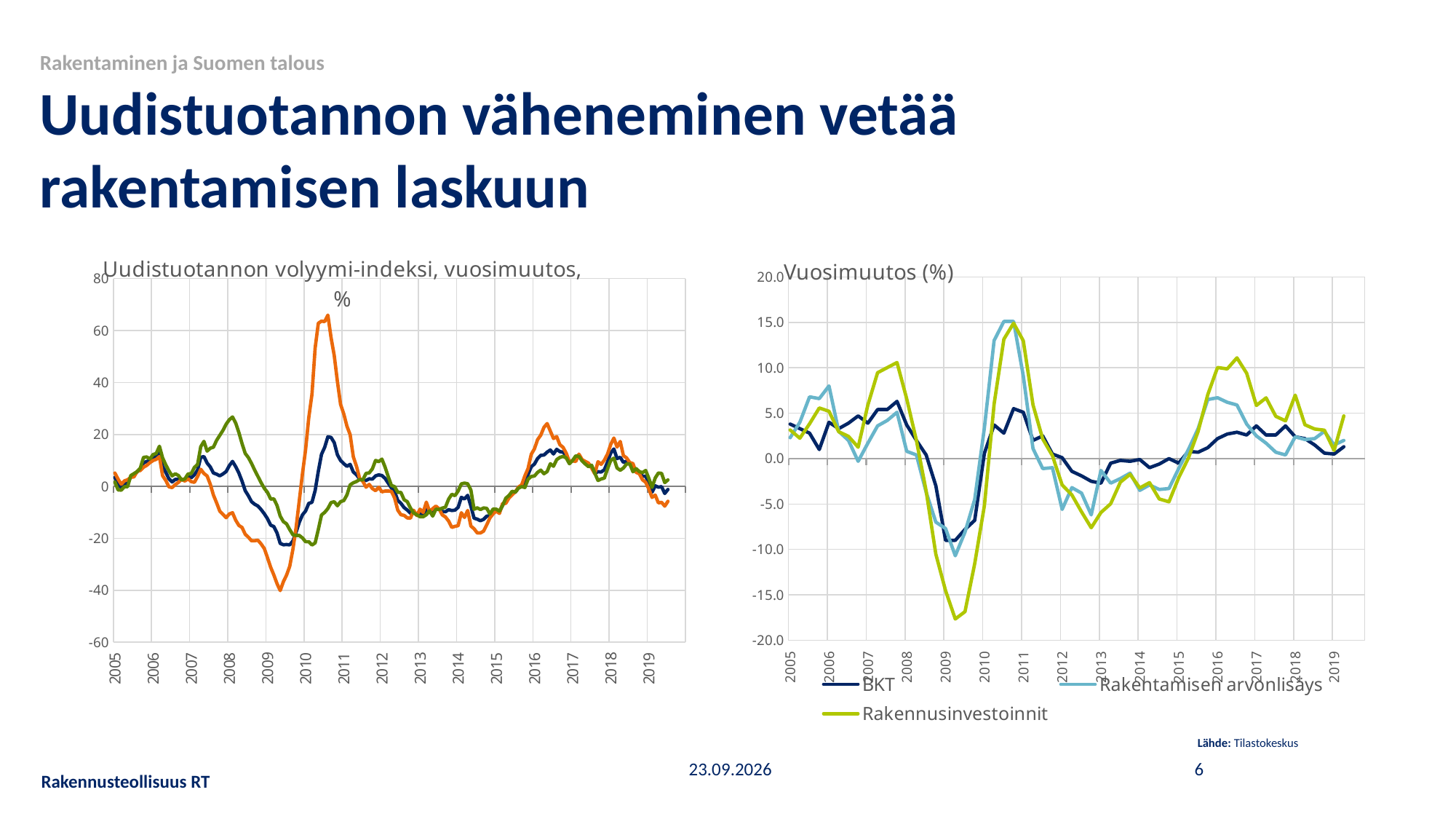
What is the highest value shown on the vertical axis of the left-hand chart 'Uudistuotannon volyymi-indeksi, vuosimuutos, %'? 80 In the right-hand chart 'Vuosimuutos (%)', does the BKT line rise or fall between 2008 and 2009? fall In the right-hand chart 'Vuosimuutos (%)', is the peak value of Rakennusinvestoinnit around 2016 greater or less than 10.0? greater In the right-hand chart 'Vuosimuutos (%)', is the lowest value of BKT around 2009 greater or less than -10.0? greater What kind of chart is the right-hand chart titled 'Vuosimuutos (%)'? line chart In the right-hand chart 'Vuosimuutos (%)', is the lowest value of Rakennusinvestoinnit around 2009 greater or less than -15.0? less What kind of chart is the left-hand chart titled 'Uudistuotannon volyymi-indeksi, vuosimuutos, %'? line chart In the right-hand chart 'Vuosimuutos (%)', does the Rakennusinvestoinnit line rise or fall between 2009 and 2010? rise In the right-hand chart 'Vuosimuutos (%)', which series is drawn in light blue according to the legend? Rakentamisen arvonlisäys How many series does the legend of the right-hand chart 'Vuosimuutos (%)' list? 3 How many year labels are shown on the x axis of the right-hand chart 'Vuosimuutos (%)'? 15 In the right-hand chart 'Vuosimuutos (%)', which series reaches the lowest value around 2009? Rakennusinvestoinnit